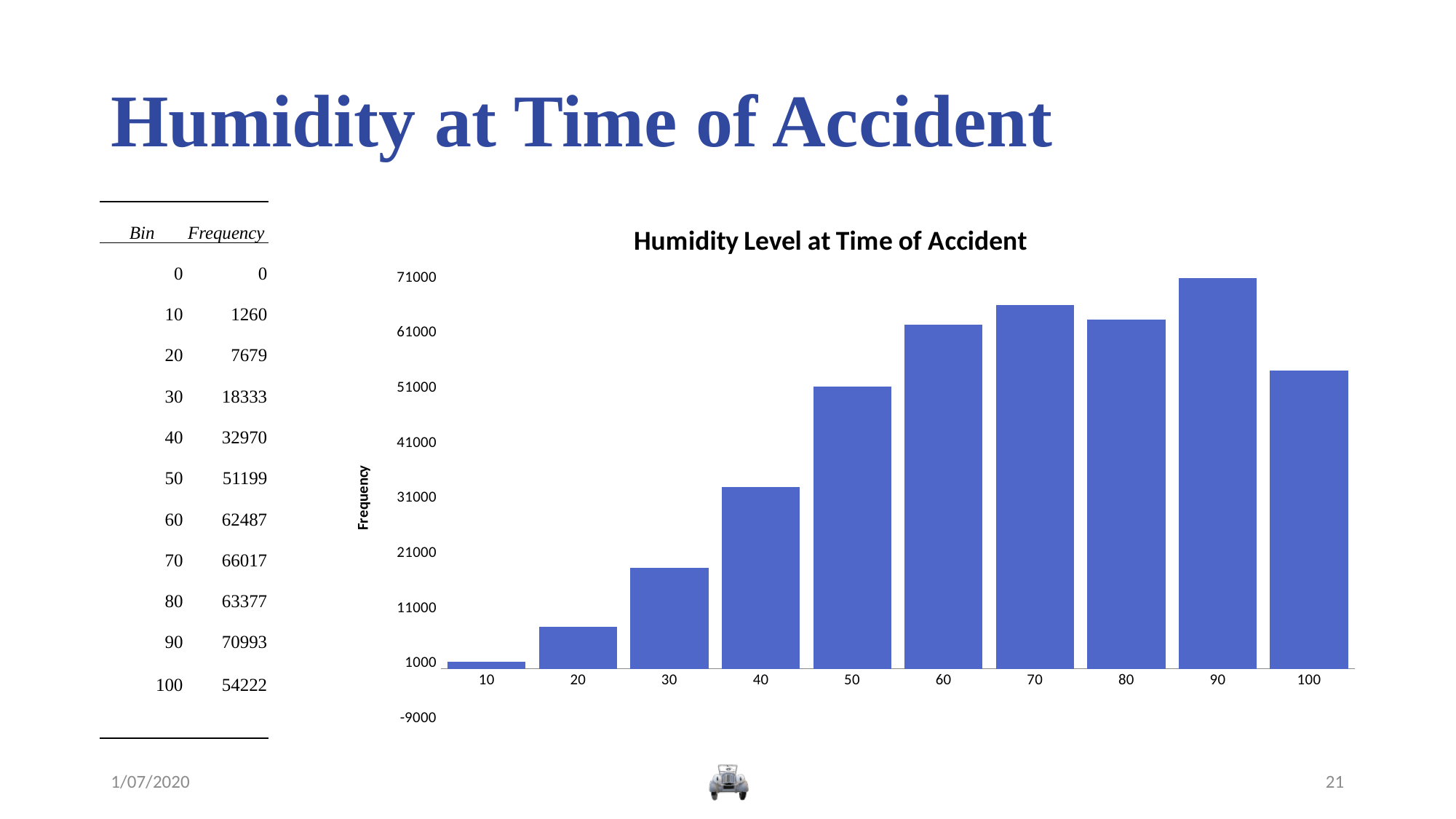
What is the title of the chart? Humidity Level at Time of Accident According to the table on the slide, what is the frequency for bin 40? 32970 What type of chart is shown on the slide? bar chart Which bar is taller in the chart, bin 40 or bin 100? 100 Using the table values, what is the difference between the frequency for bin 90 and the frequency for bin 10? 69733 Which humidity bin has the lowest frequency among the bars plotted in the chart? 10 Which humidity bin has the highest frequency in the chart? 90 Is the value for bin 30 in the chart greater or less than 21000? less Do the bar heights rise or fall from bin 10 to bin 90 along the x axis? rise How many bars are plotted in the chart? 10 Is the value for bin 50 in the chart greater or less than 41000? greater According to the table on the slide, what is the frequency for bin 90? 70993